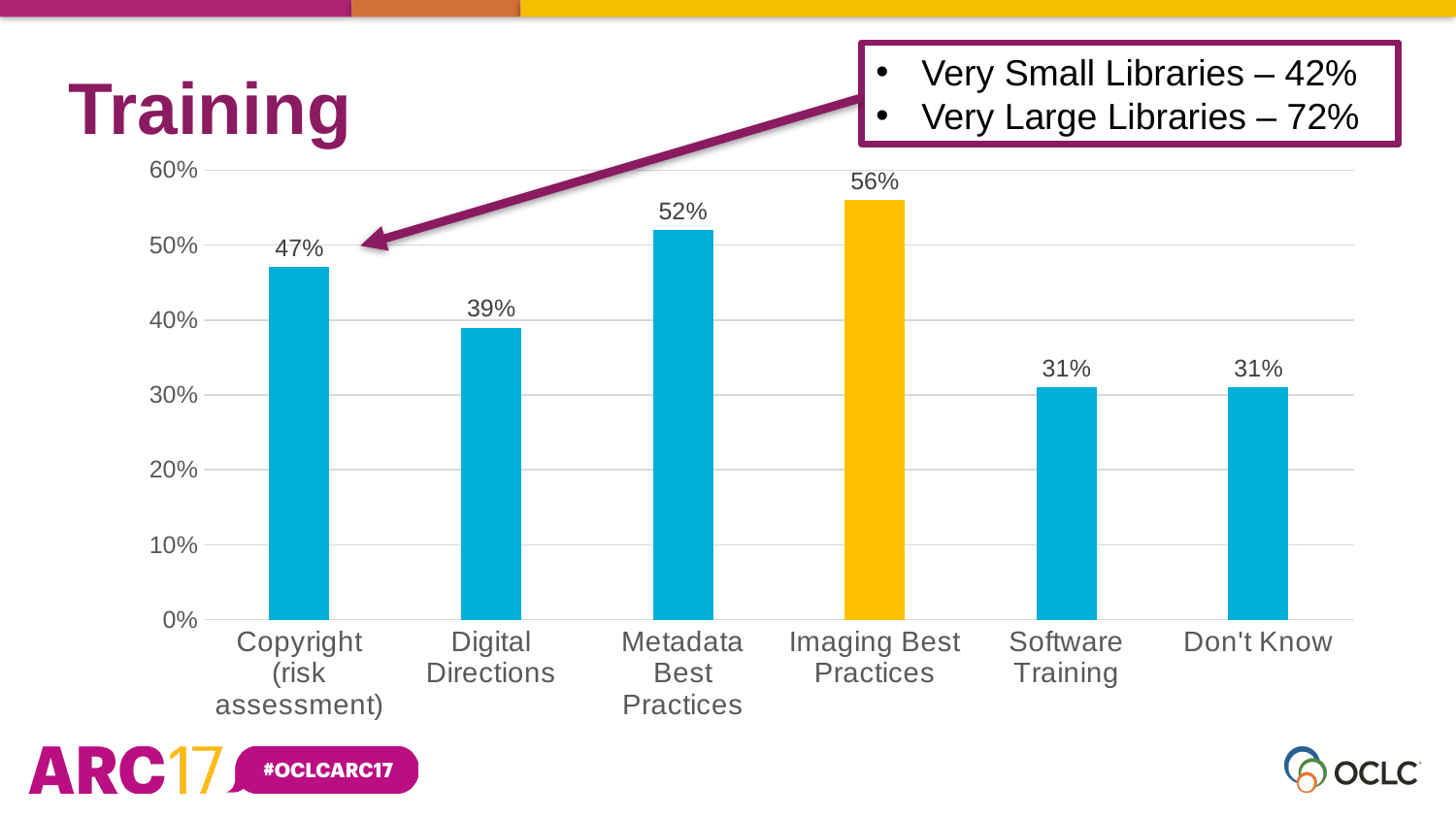
What is the difference between Imaging Best Practices and Metadata Best Practices? 4% How many categories are shown on the chart? 6 What is the value for Copyright (risk assessment)? 47% What is the value for Digital Directions? 39% What is the title of the slide containing the chart? Training What is the value for Imaging Best Practices? 56% What is the difference between Copyright (risk assessment) and Software Training? 16% Which category has the highest value? Imaging Best Practices Which is larger, Metadata Best Practices or Digital Directions? Metadata Best Practices Which bar is highlighted in a different colour (yellow) from the others? Imaging Best Practices What kind of chart is shown on the slide? bar chart Is the value for Digital Directions greater or less than 40%? less